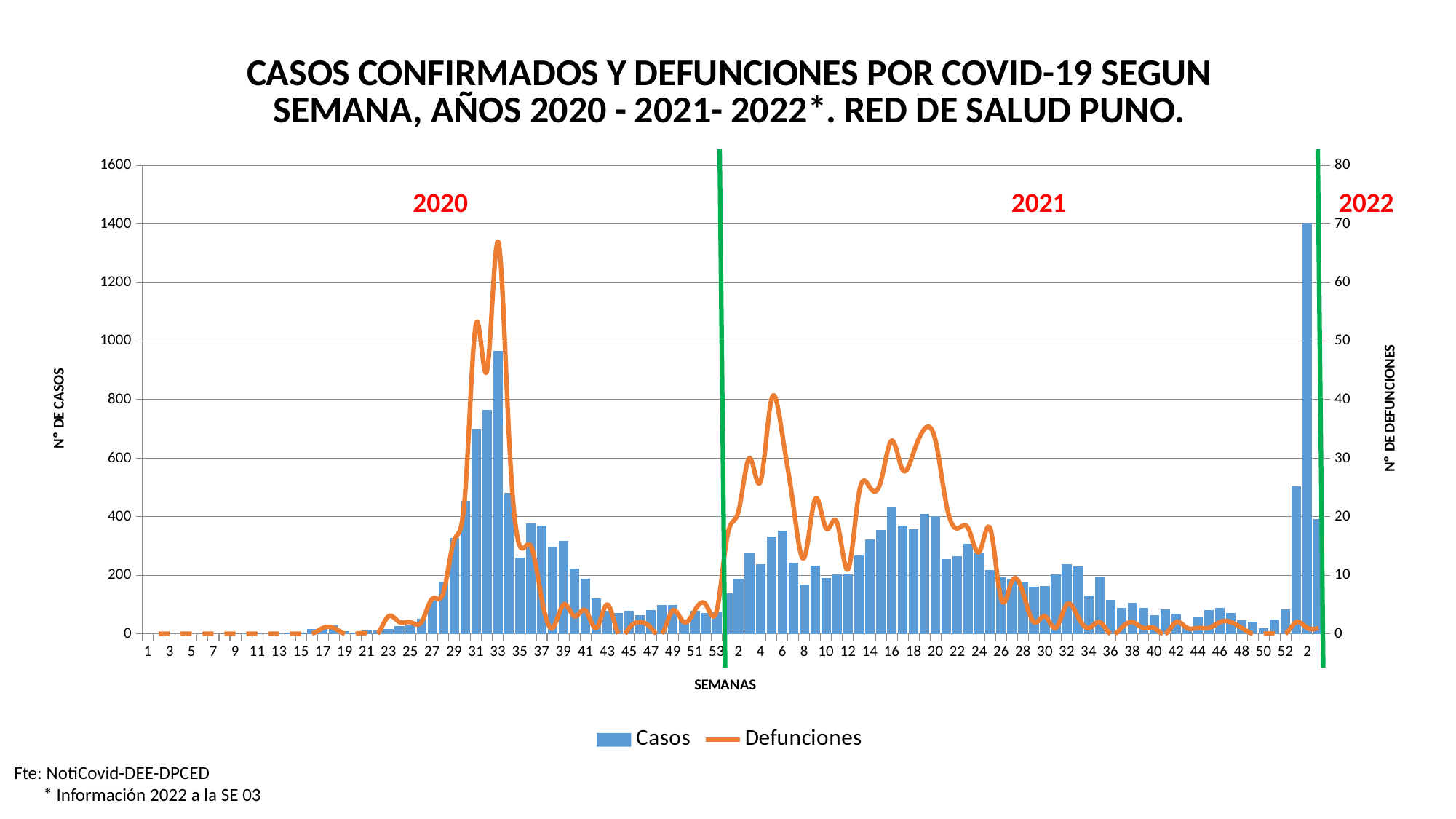
What are the two series named in the legend? Casos and Defunciones Which is larger, the Casos bar for week 33 of 2020 or the Casos bar for week 16 of 2021? Week 33 of 2020 Is the Casos value for week 16 of 2021 greater or less than 600? less Which week has the tallest Casos bar in the whole chart? Week 2 of 2022 Is the Casos value for week 33 of 2020 greater or less than 800? greater Is the Casos value for week 2 of 2022 greater or less than 1200? greater Do the Casos bars rise or fall from week 29 to week 33 of 2020? rise How many series does the legend list? 2 What kind of chart is shown on the slide? A bar chart combined with a line chart What is the title of the left vertical axis? N° DE CASOS